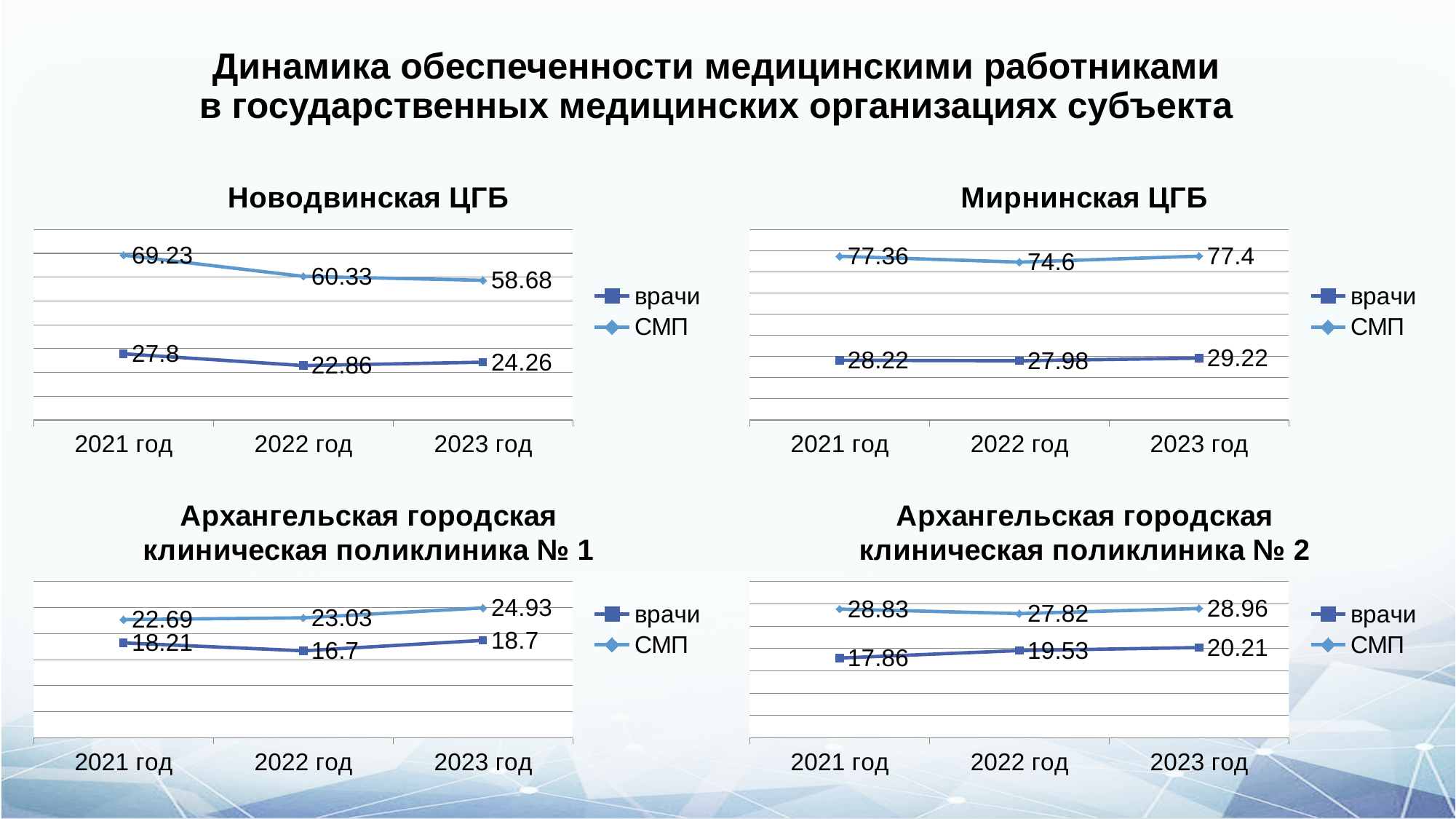
In the Новодвинская ЦГБ chart, what is the value for врачи in 2022 год? 22.86 How many years are shown on the x axis of the Архангельская городская клиническая поликлиника № 1 chart? 3 In the Мирнинская ЦГБ chart, in which year is the value for СМП the lowest? 2022 год In the Новодвинская ЦГБ chart, does the value for СМП rise or fall from 2021 год to 2023 год? fall How many series does the legend of the Мирнинская ЦГБ chart list? 2 In the Новодвинская ЦГБ chart, what is the value for СМП in 2021 год? 69.23 In the Архангельская городская клиническая поликлиника № 1 chart, what is the difference between the СМП and врачи values in 2023 год? 6.23 In the Архангельская городская клиническая поликлиника № 1 chart, in which year is the value for врачи the lowest? 2022 год In the Архангельская городская клиническая поликлиника № 2 chart, which is larger: the СМП value in 2021 год or in 2022 год? 2021 год What kind of chart is the Новодвинская ЦГБ chart? line chart In the Мирнинская ЦГБ chart, what is the value for врачи in 2023 год? 29.22 In the Архангельская городская клиническая поликлиника № 2 chart, does the value for врачи rise or fall from 2021 год to 2023 год? rise